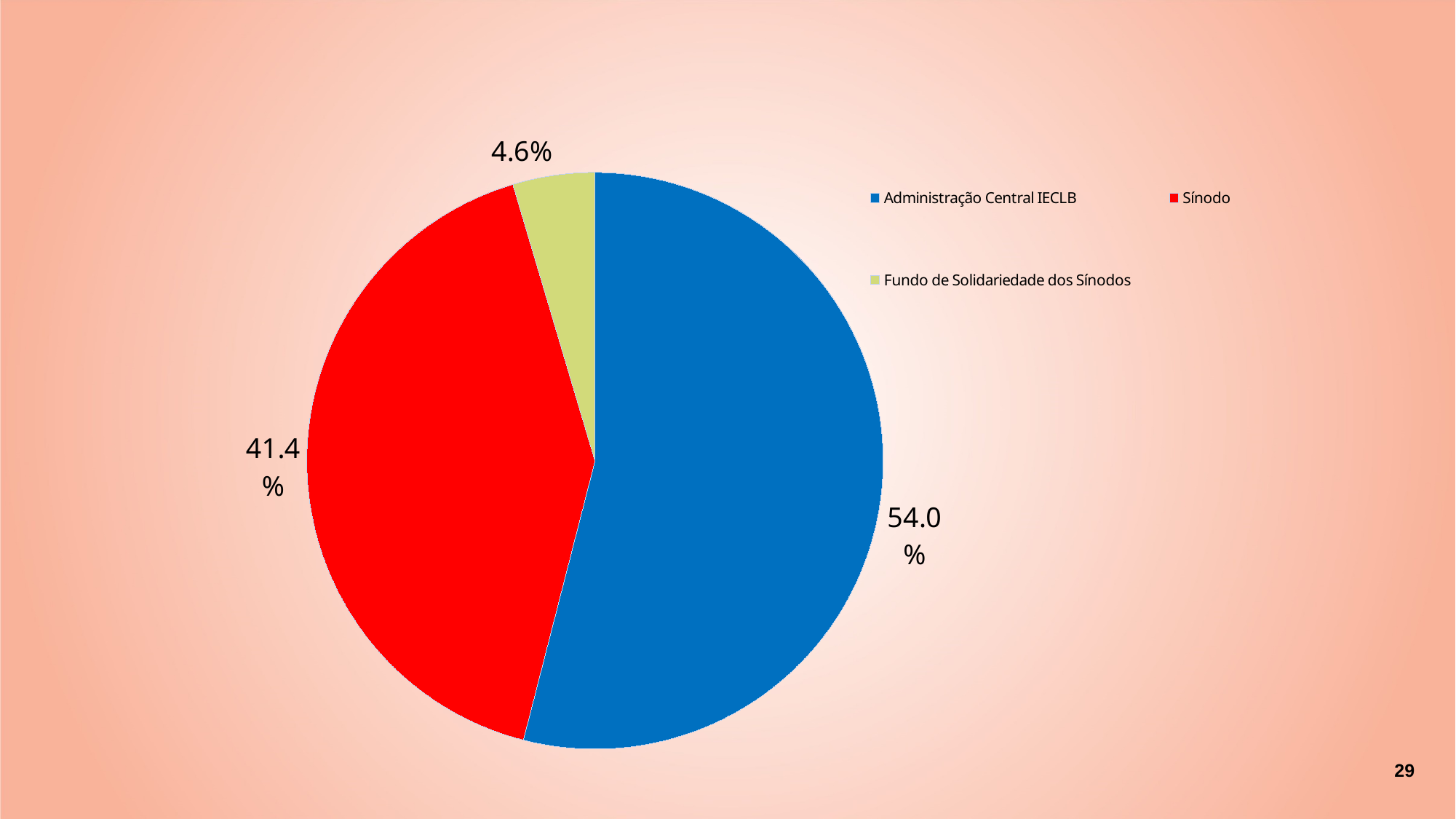
Which category has the smallest slice of the pie? Fundo de Solidariedade dos Sínodos Which category has the largest slice of the pie? Administração Central IECLB What share of the pie does Fundo de Solidariedade dos Sínodos have? 4.6% What share of the pie does Administração Central IECLB have? 54.0% Which is larger, the slice for Sínodo or the slice for Fundo de Solidariedade dos Sínodos? Sínodo What kind of chart is shown on the slide? Pie chart What share of the pie does Sínodo have? 41.4% How many slices does the pie chart have? 3 What colour is the slice for Administração Central IECLB? Blue What is the difference in percentage points between Administração Central IECLB and Sínodo? 12.6 What colour is the slice for Sínodo? Red How many entries does the legend list? 3